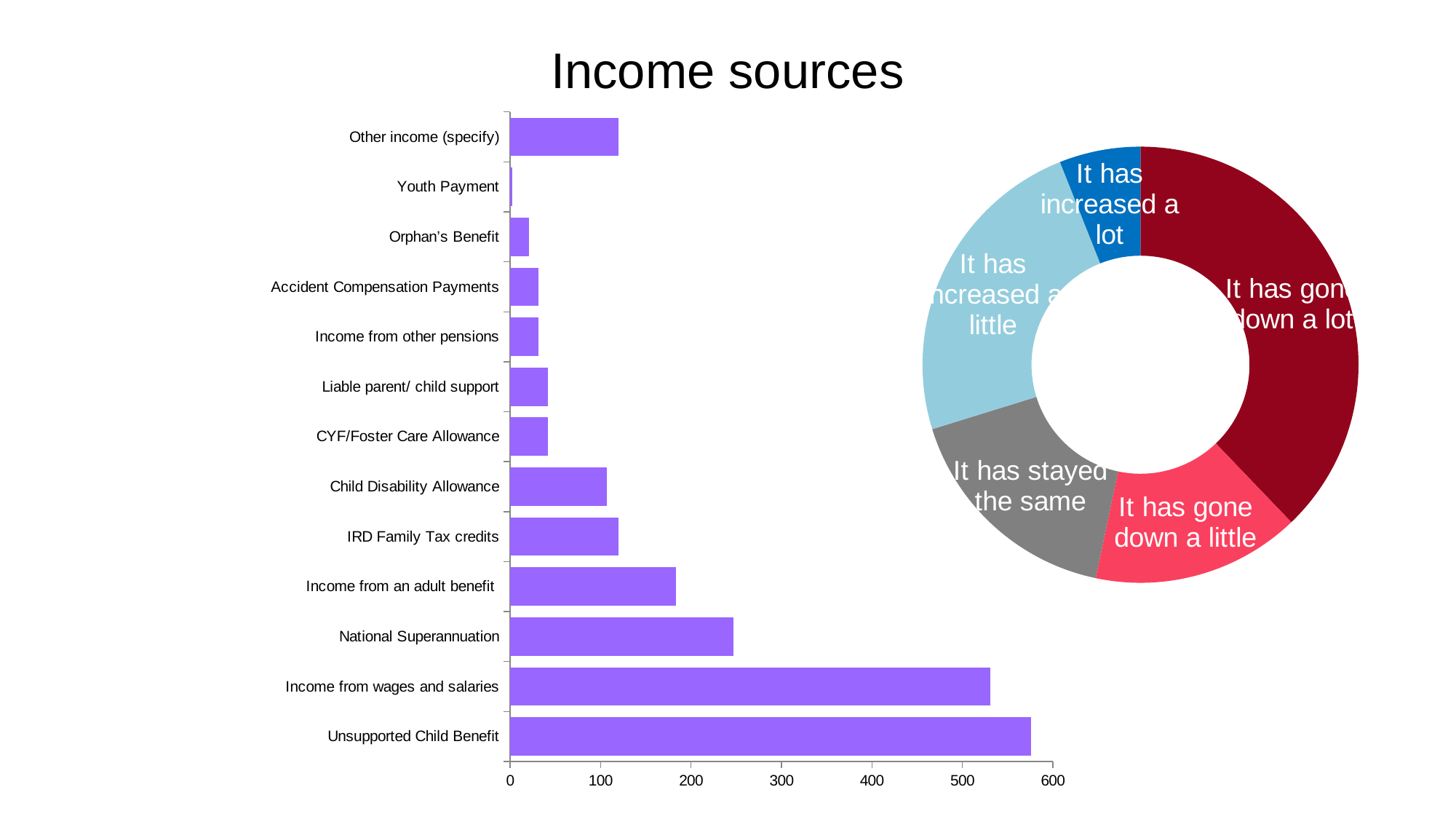
What kind of chart is the chart on the right of the slide? doughnut chart In the bar chart on the left, which is larger: Income from wages and salaries or National Superannuation? Income from wages and salaries In the bar chart on the left, which income source has the highest value? Unsupported Child Benefit In the bar chart on the left, is the value for Income from wages and salaries greater or less than 500? greater In the bar chart on the left, which income source has the lowest value? Youth Payment What kind of chart is the chart on the left of the slide? bar chart In the bar chart on the left, is the value for Orphan's Benefit greater or less than 100? less In the doughnut chart on the right, how many segments are there? 5 In the bar chart on the left, how many income source categories are plotted? 13 In the bar chart on the left, is the value for Income from an adult benefit greater or less than 200? less In the doughnut chart on the right, which segment is the largest? It has gone down a lot